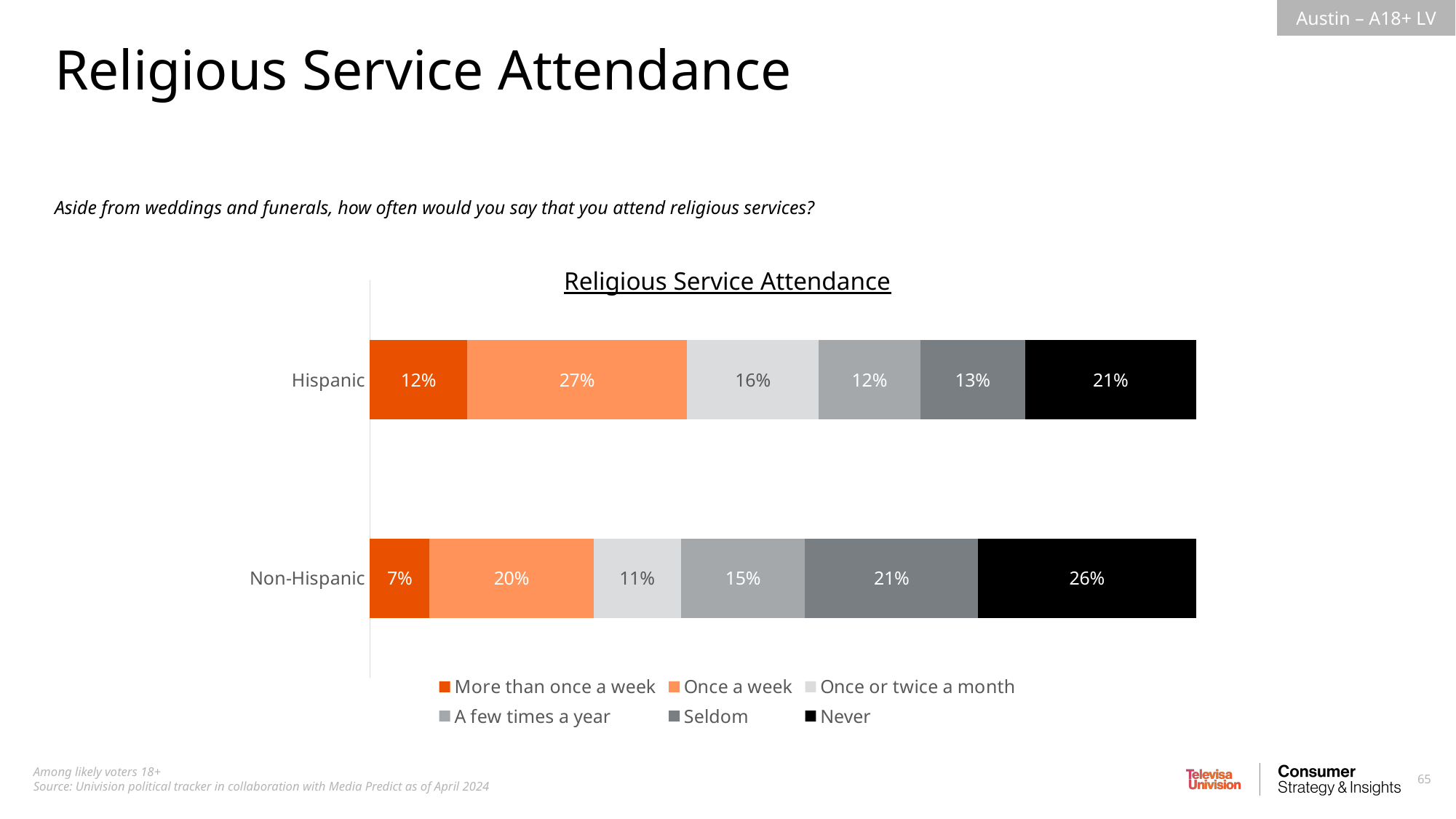
What is the difference between the Non-Hispanic and Hispanic percentages for 'Seldom'? 8% Which attendance category has the smallest share among Non-Hispanic respondents? More than once a week How many series does the legend list? 6 What type of chart is shown on the slide? Stacked bar chart Which attendance category has the largest share among Hispanic respondents? Once a week Which group has the higher share of respondents who attend religious services once a week, Hispanic or Non-Hispanic? Hispanic How many groups (bars) are shown in the chart? 2 What percentage of Hispanic respondents attend religious services a few times a year? 12% What is the difference between the Hispanic and Non-Hispanic percentages for 'Once or twice a month'? 5% What percentage of Non-Hispanic respondents attend religious services more than once a week? 7% What percentage of Hispanic respondents attend religious services once a week? 27% What percentage of Non-Hispanic respondents say they never attend religious services? 26%